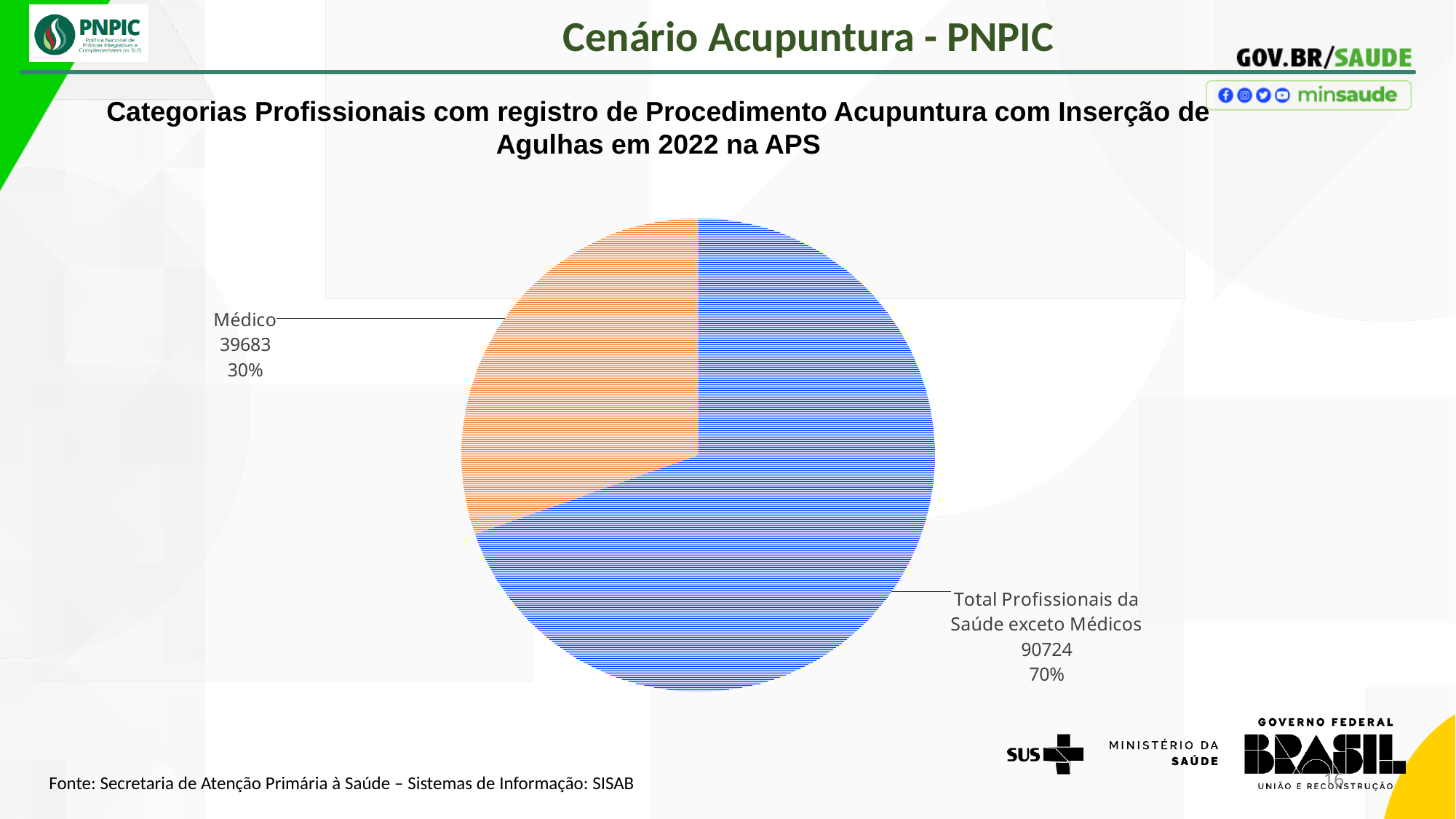
What type of chart is shown on the slide? pie chart Which is larger, the value for Médico or the value for Total Profissionais da Saúde exceto Médicos? Total Profissionais da Saúde exceto Médicos Which category has the largest slice? Total Profissionais da Saúde exceto Médicos What is the difference between the value for Total Profissionais da Saúde exceto Médicos and the value for Médico? 51041 What is the value for Médico? 39683 What colour is the Médico slice? orange What is the value for Total Profissionais da Saúde exceto Médicos? 90724 What share of the pie does the Médico slice represent? 30% Which category has the smallest slice? Médico What share of the pie does the Total Profissionais da Saúde exceto Médicos slice represent? 70% How many categories are shown in the pie chart? 2 What is the total of the two values shown in the pie chart? 130407